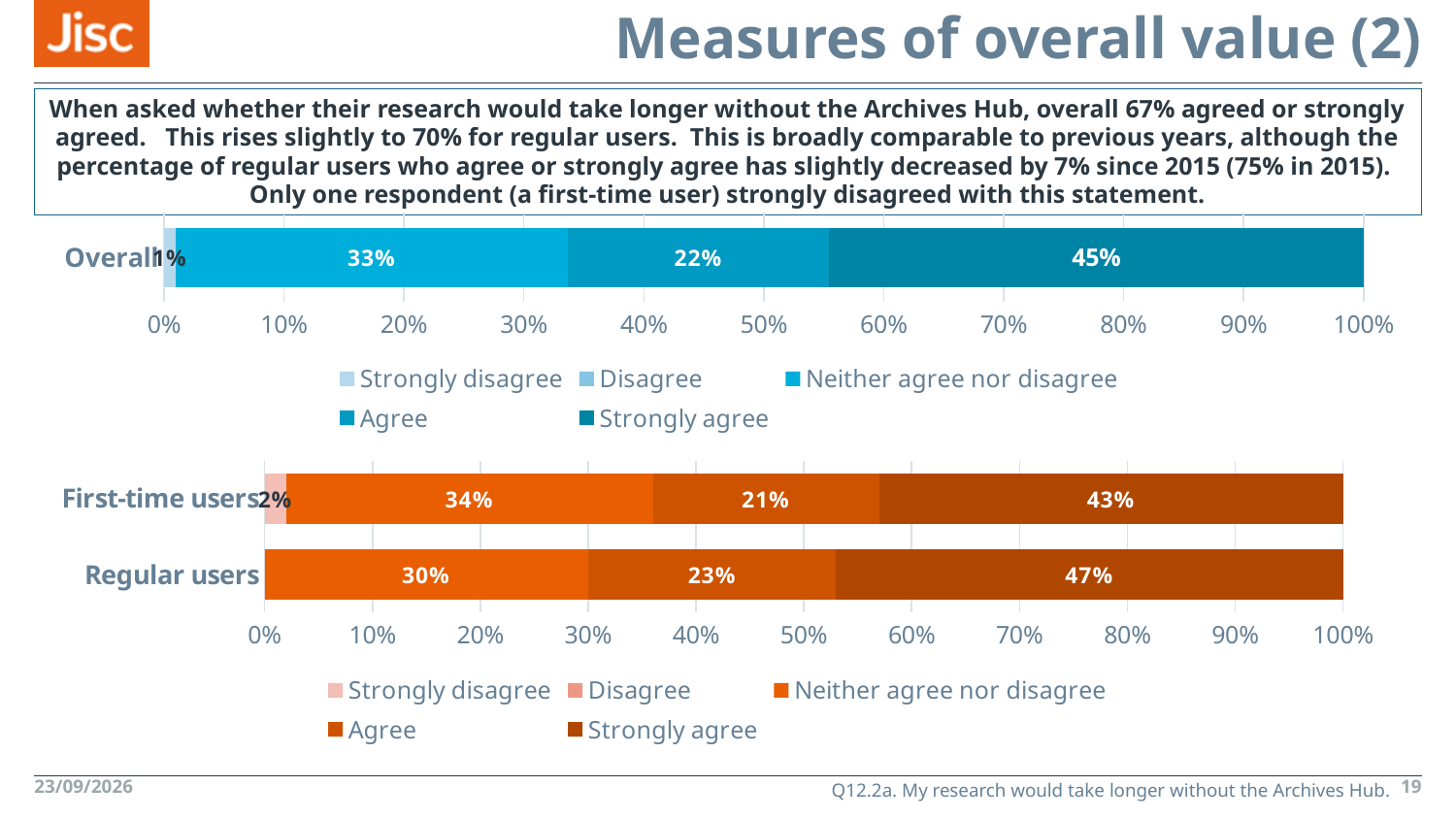
In the top chart, what percentage of Overall respondents strongly agree? 45% What kind of chart is the top chart? Stacked bar chart In the top chart, what is the difference between the Strongly agree and Agree values for Overall? 23 percentage points In the top chart, what is the Neither agree nor disagree value for Overall? 33% How many categories are plotted in the bottom chart? 2 In the top chart, what is the Agree value for Overall? 22% How many series does the legend of the bottom chart list? 5 In the bottom chart, how much higher is the Strongly agree value for Regular users than for First-time users? 4 percentage points In the bottom chart, what is the Neither agree nor disagree value for First-time users? 34% In the bottom chart, what is the Agree value for Regular users? 23% In the bottom chart, what is the Strongly agree value for Regular users? 47% In the bottom chart, which group has the higher Strongly agree value, First-time users or Regular users? Regular users